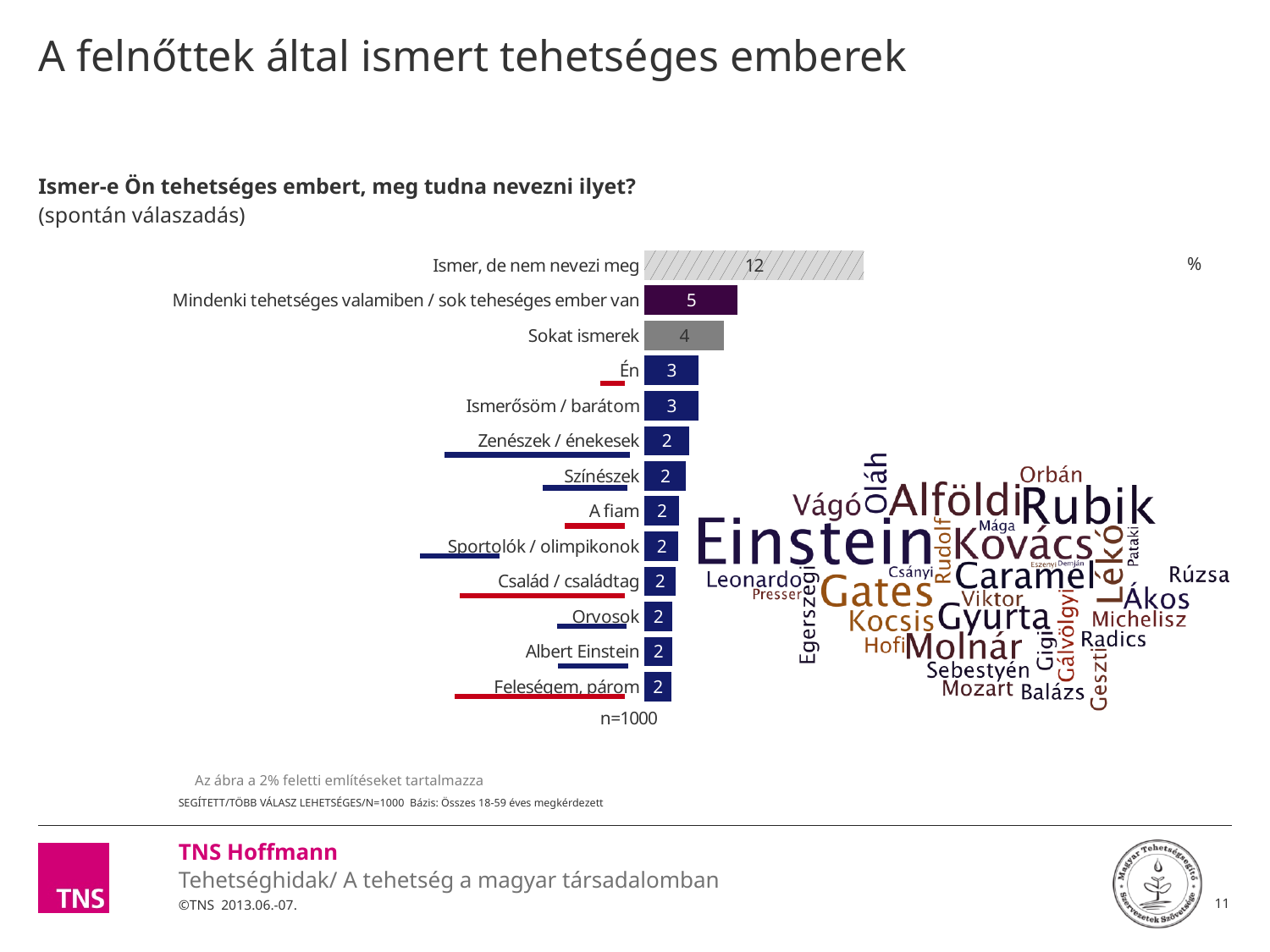
What is the difference between the values for "Sokat ismerek" and "Én"? 1 What value is shown for "Albert Einstein"? 2 What sample size (n) is stated below the bar chart? n=1000 What value is shown for "Mindenki tehetséges valamiben / sok teheséges ember van"? 5 What is the difference between the values for "Ismer, de nem nevezi meg" and "Mindenki tehetséges valamiben / sok teheséges ember van"? 7 Which category has the highest value in the bar chart? Ismer, de nem nevezi meg What value is shown for "Sokat ismerek"? 4 How many categories are shown in the bar chart? 13 Which is larger, the value for "Sokat ismerek" or the value for "Ismerősöm / barátom"? Sokat ismerek What value is shown for "Ismer, de nem nevezi meg"? 12 What kind of chart is shown on the slide? Bar chart Do the values rise or fall going from the top category to the bottom category? Fall